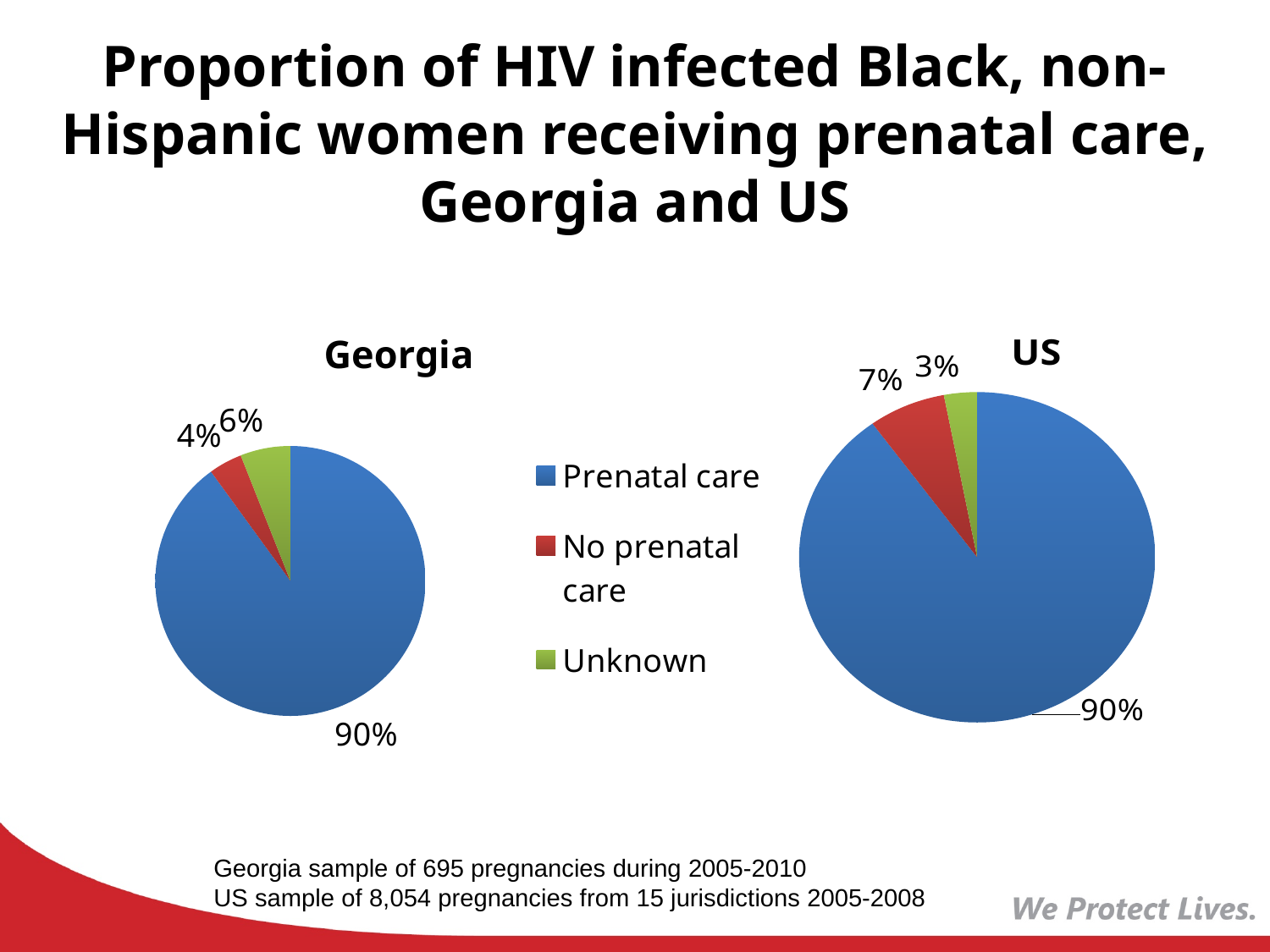
In the US pie chart, what share is Unknown? 3% In the Georgia pie chart, which category has the smallest slice? No prenatal care In the Georgia pie chart, what share of women received prenatal care? 90% In the US pie chart, what share of women received prenatal care? 90% How many categories does the legend list? 3 Which is larger: the No prenatal care share in the US chart or in the Georgia chart? US What is the difference between the No prenatal care share in the US chart and in the Georgia chart? 3% In the US pie chart, which category has the smallest slice? Unknown What type of chart is used for the Georgia data? Pie chart